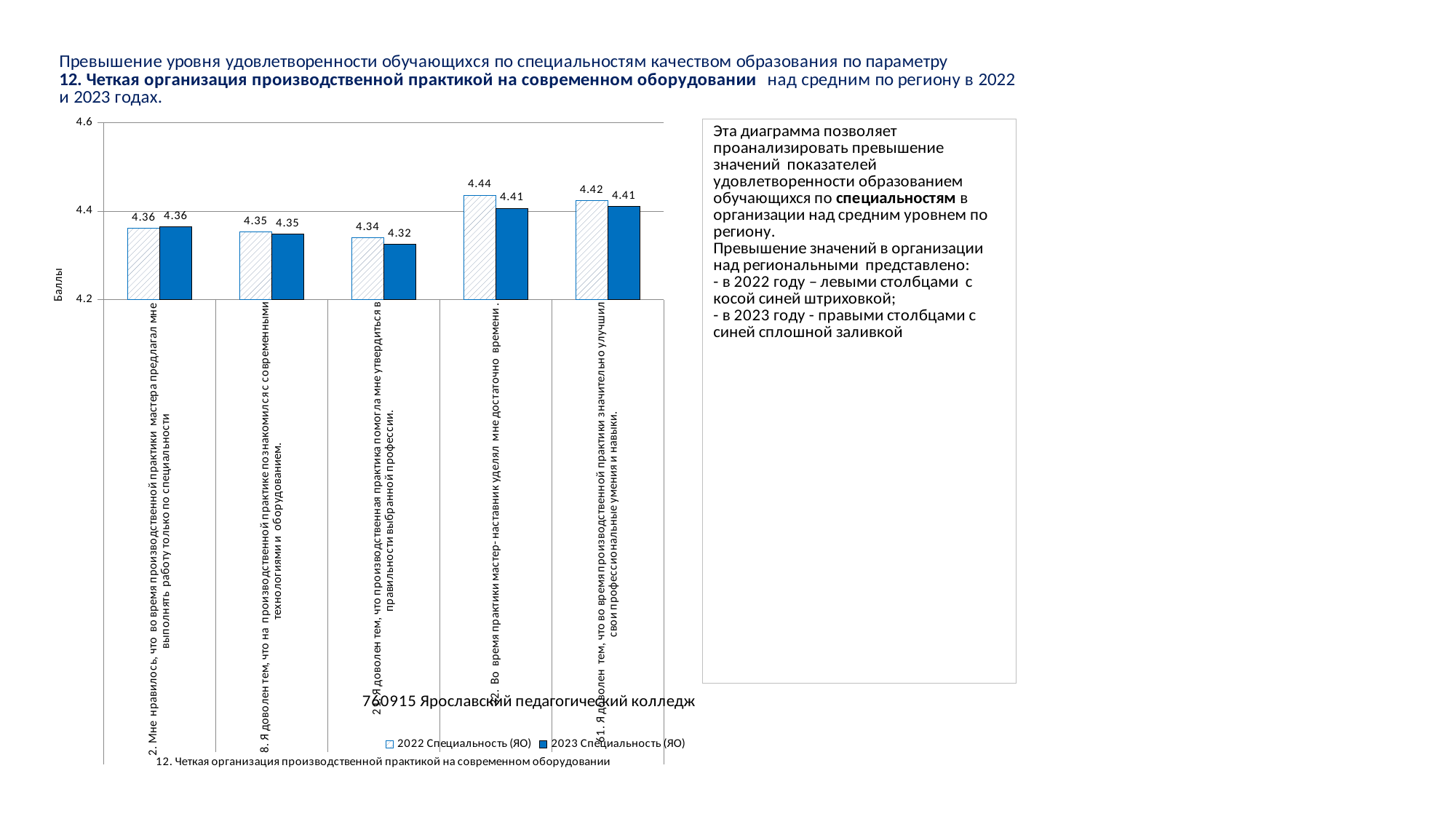
What is the 2022 Специальность (ЯО) value for statement 31 ("Я доволен тем, что во время производственной практики значительно улучшил свои профессиональные умения и навыки")? 4.42 What is the 2023 Специальность (ЯО) value for statement 21 ("Я доволен тем, что производственная практика помогла мне утвердиться в правильности выбранной профессии")? 4.32 How many series does the chart legend list? 2 Is the 2023 Специальность (ЯО) value for statement 8 greater or less than 4.4? less How many categories (statements) are plotted on the x axis of the chart? 5 What is the 2022 Специальность (ЯО) value for statement 22 ("Во время практики мастер-наставник уделял мне достаточно времени")? 4.44 Which statement has the lowest 2023 Специальность (ЯО) value? 21. Я доволен тем, что производственная практика помогла мне утвердиться в правильности выбранной профессии What type of chart is shown on the slide? Bar chart What is the label of the y axis of the chart? Баллы For statement 21, which is larger: the 2022 Специальность (ЯО) value or the 2023 Специальность (ЯО) value? 2022 Специальность (ЯО) Which statement has the highest 2022 Специальность (ЯО) value? 32. Во время практики мастер-наставник уделял мне достаточно времени